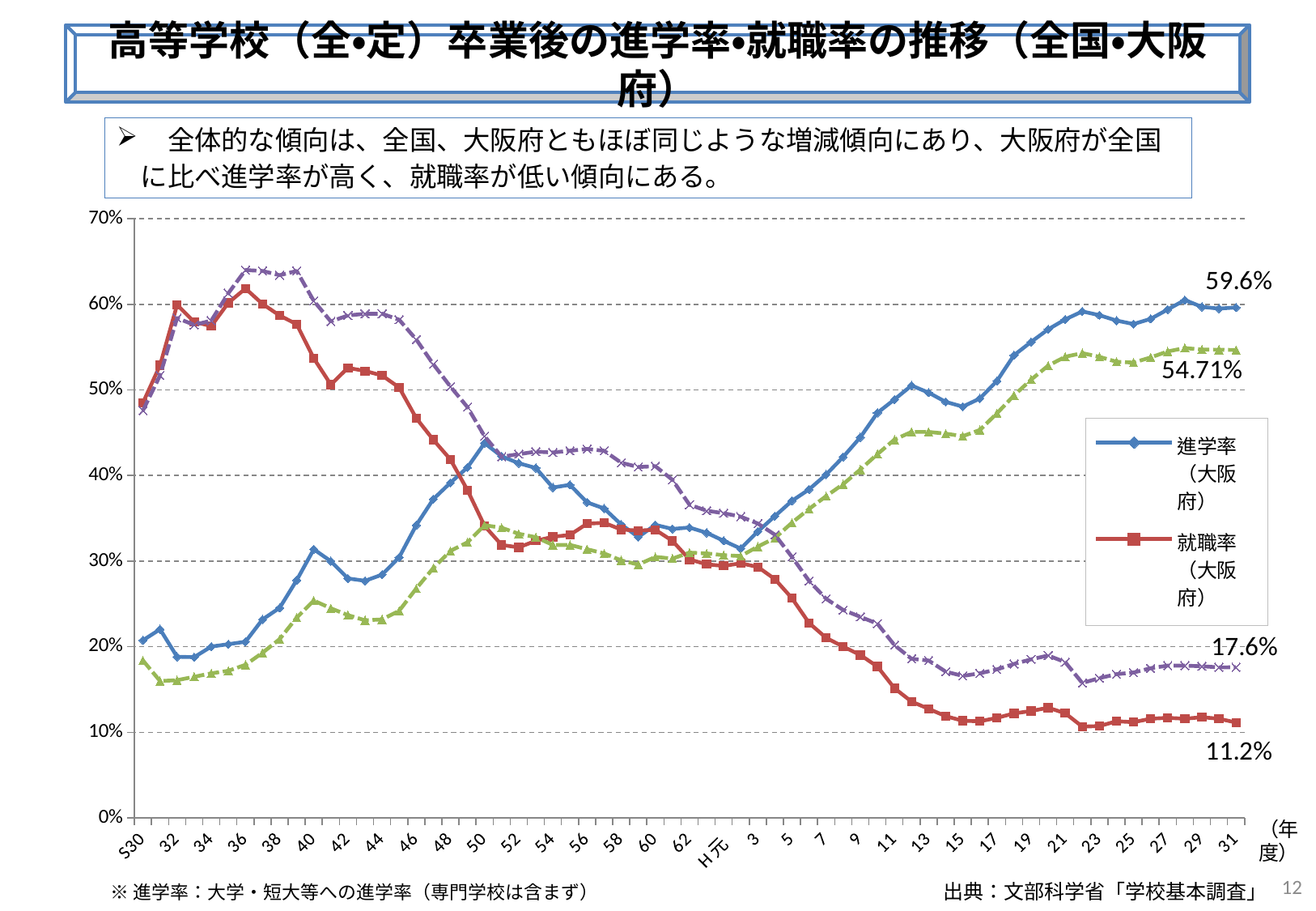
What is the value of 進学率（大阪府） at the final year (H31) according to the data label? 59.6% What is the value of 就職率（大阪府） at the final year (H31) according to the data label? 11.2% What kind of chart is shown on the slide? line chart What data label is shown at the end of the green triangle-marker line? 54.71% Is the value of 進学率（大阪府） at S30 greater or less than 30%? less What is the difference between the final labelled values of 進学率（大阪府） (59.6%) and 就職率（大阪府） (11.2%)? 48.4 percentage points At H31, which is higher: 進学率（大阪府） or 就職率（大阪府）? 進学率（大阪府） What data label is shown at the end of the purple x-marker line? 17.6% Does 就職率（大阪府） rise or fall between H元 and H15? fall Is the value of 就職率（大阪府） at S36 greater or less than 50%? greater Does 進学率（大阪府） rise or fall between H3 and H21? rise How many series does the legend list? 2